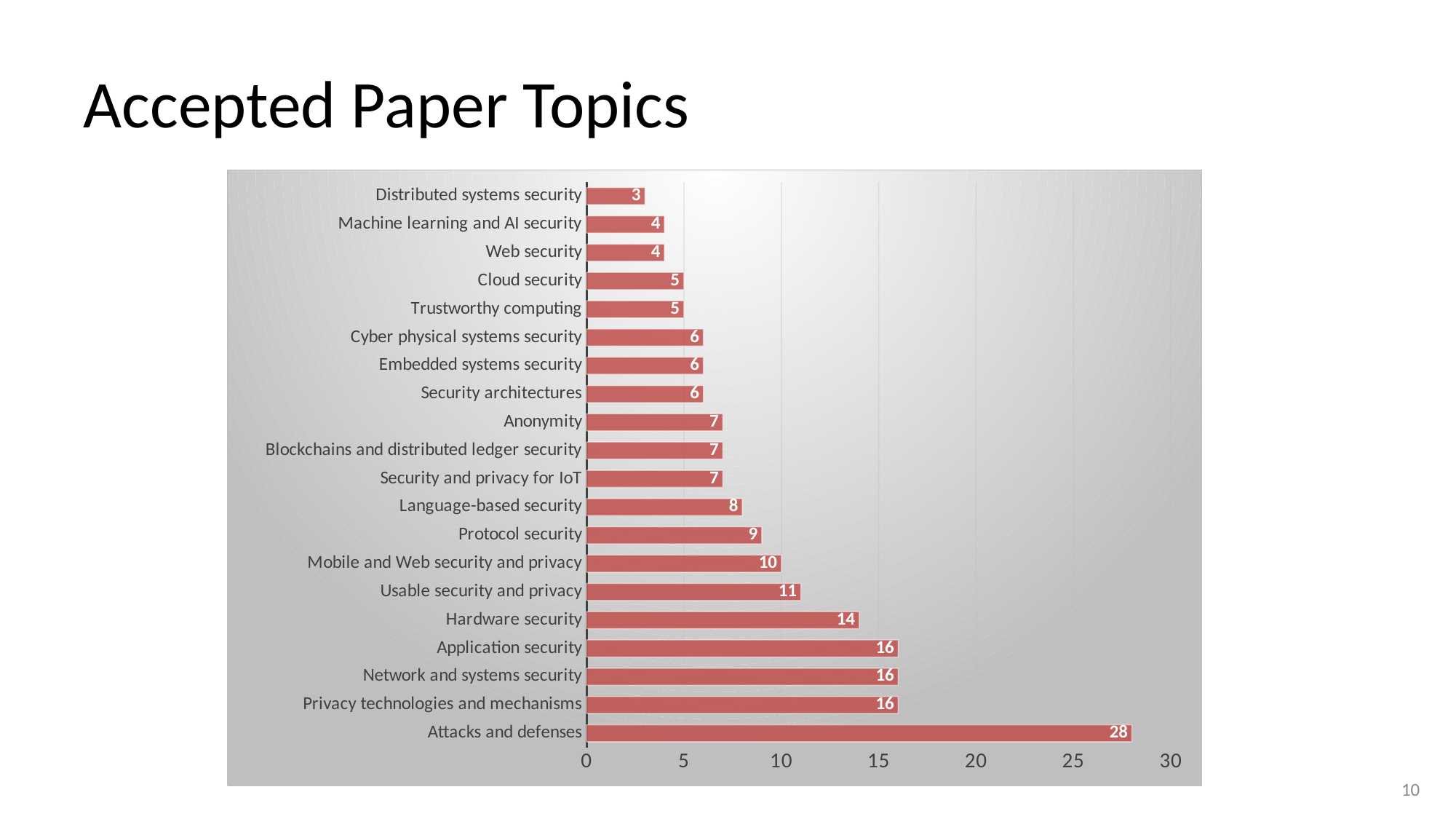
What is the value for Usable security and privacy? 11 What kind of chart is shown on the slide? bar chart What is the title of the slide containing the chart? Accepted Paper Topics What is the value for Language-based security? 8 What is the value for Attacks and defenses? 28 Which topic has the lowest value? Distributed systems security Is the value for Mobile and Web security and privacy greater or less than 5? greater Which is larger, the value for Protocol security or the value for Cloud security? Protocol security How many topics are shown in the chart? 20 What is the difference between the values for Attacks and defenses and Application security? 12 What is the value for Hardware security? 14 Which topic has the highest value? Attacks and defenses